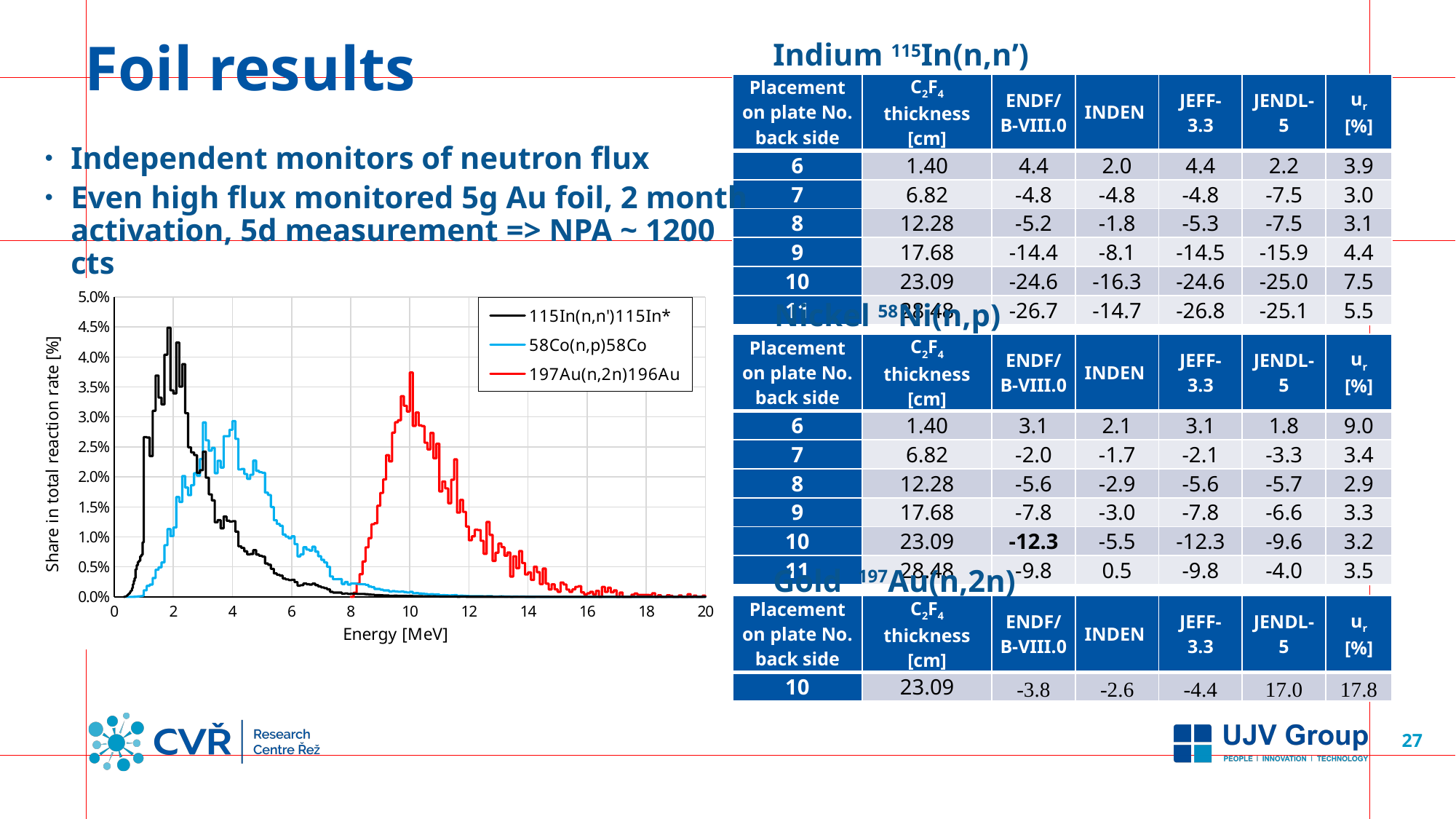
What is the title of the y axis of the chart? Share in total reaction rate [%] Is the peak value of the 58Co(n,p)58Co series greater or less than 3.5%? less Which series has its peak at the highest energy? 197Au(n,2n)196Au What is the title of the x axis of the chart? Energy [MeV] What kind of chart is shown on the slide? line chart Is the peak value of the 115In(n,n')115In* series greater or less than 4.0%? greater Is the peak value of the 197Au(n,2n)196Au series greater or less than 3.0%? greater Which series reaches the highest peak value on the chart? 115In(n,n')115In* Above 10 MeV, do the values of the 197Au(n,2n)196Au series rise or fall as energy increases? fall Which series has its peak at the lowest energy? 115In(n,n')115In* How many series does the chart legend list? 3